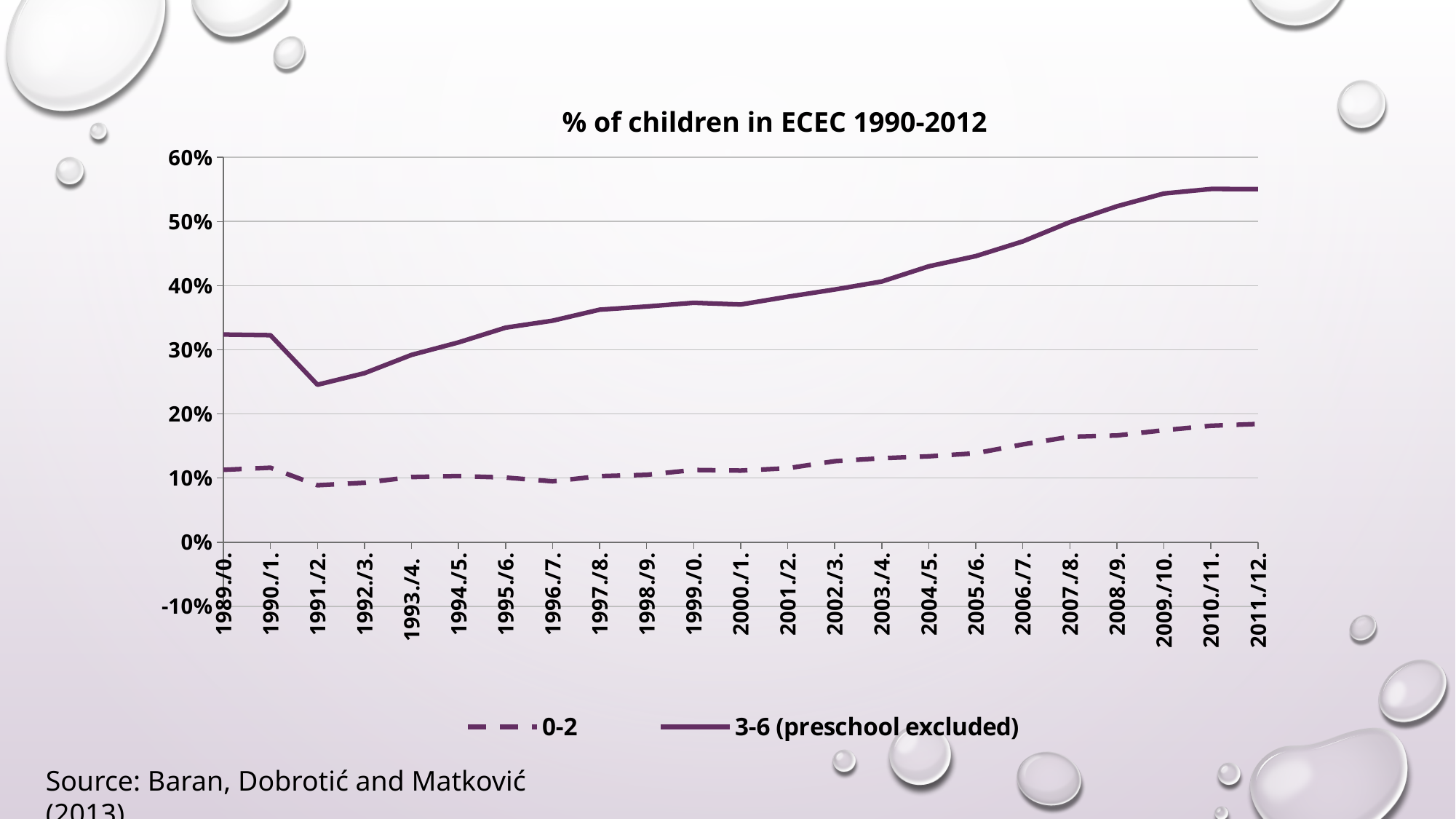
What kind of chart is shown on the slide? line chart Is the value for 0-2 in 2011./12. greater or less than 20%? less In which school year is the value for the 3-6 (preschool excluded) series lowest? 1991./2. How many series does the legend list? 2 Is the value for 0-2 in 1989./0. greater or less than 10%? greater Does the 3-6 (preschool excluded) series generally rise or fall from 1991./2. to 2011./12.? rise How many school years are shown along the x axis? 23 Is the value for 3-6 (preschool excluded) in 2011./12. greater or less than 50%? greater What is the title of the chart? % of children in ECEC 1990-2012 In 2000./1., which series has the larger value, 0-2 or 3-6 (preschool excluded)? 3-6 (preschool excluded) Which series is drawn with a dashed line? 0-2